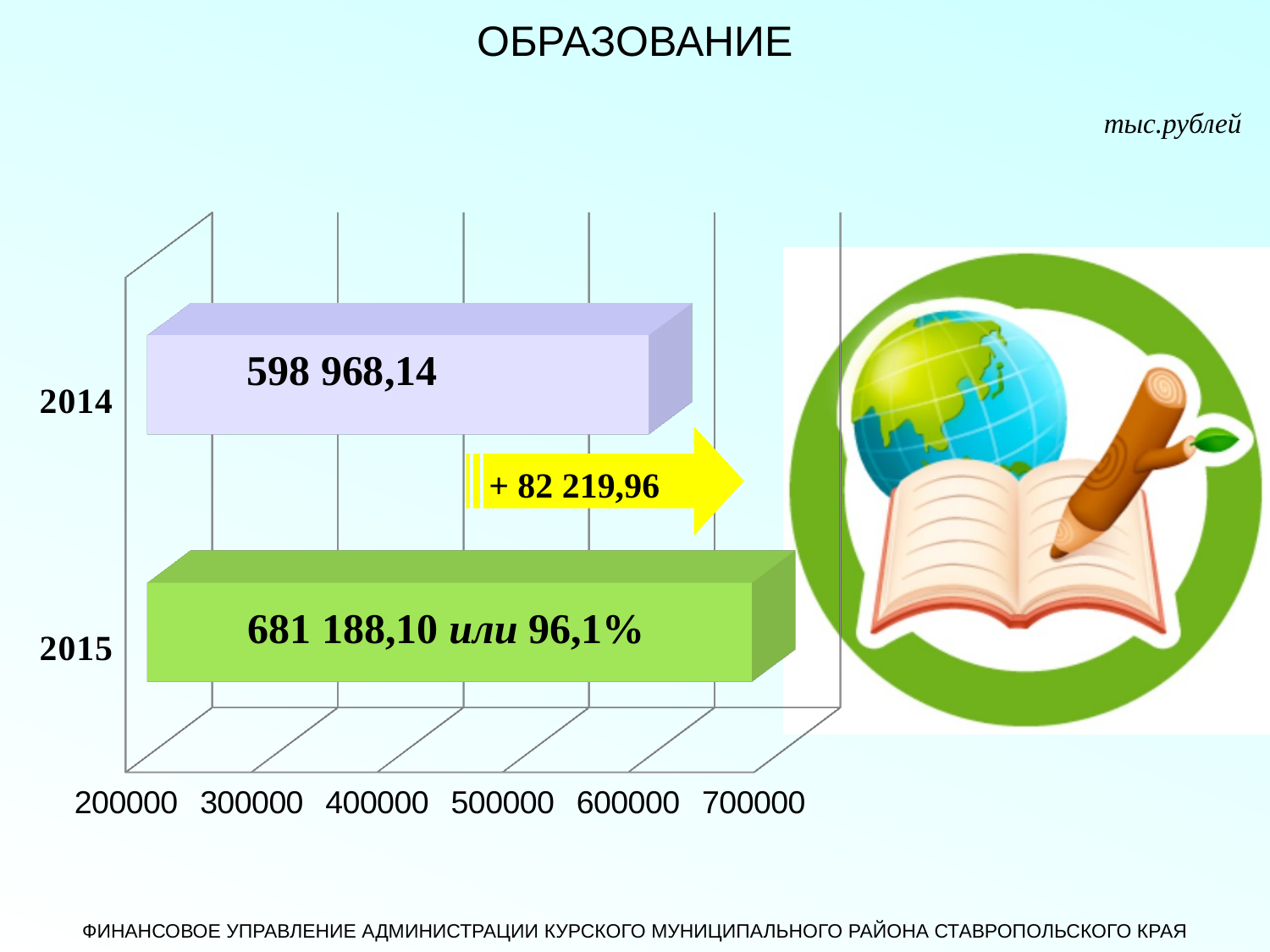
What percentage is shown next to the 2015 value? 96,1% What is the value for 2014? 598 968,14 By how much does the 2015 value exceed the 2014 value? 82 219,96 Is the value for 2014 greater or less than 600000? less Which year has the higher value? 2015 What is the value for 2015? 681 188,10 Is the value for 2015 larger than the value for 2014? Yes What kind of chart is shown on the slide? Bar chart What is the title of the slide? ОБРАЗОВАНИЕ Is the value for 2015 greater or less than 600000? greater Which year has the lower value? 2014 How many bars are shown in the chart? 2